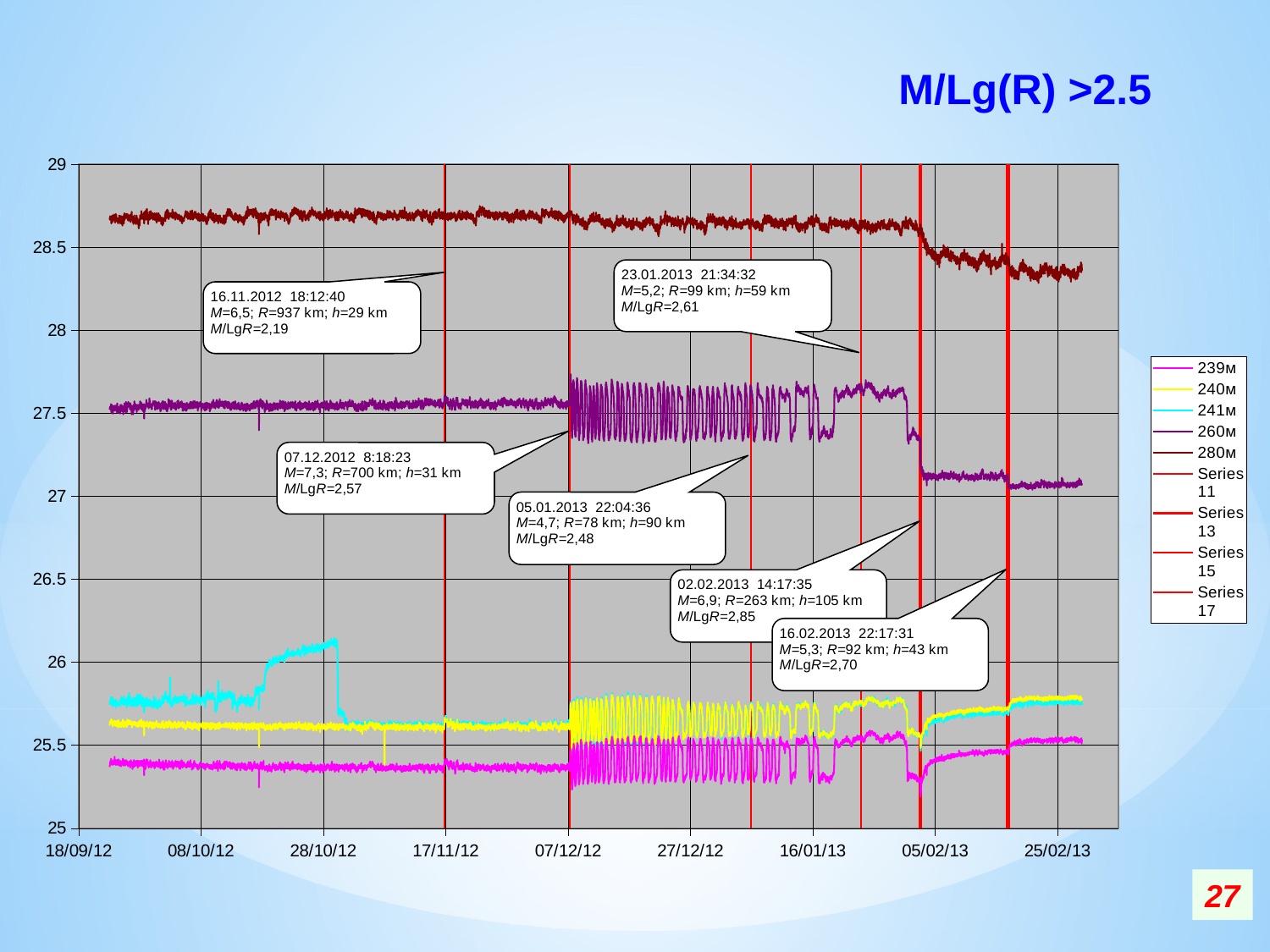
What is the title of the chart? M/Lg(R) >2.5 Which series has the highest values on the chart? 280м Which series has larger values, 280м or 260м? 280м Is the value of the 260м series at the end of the chart greater or less than 27.5? less What magnitude M is given in the annotation for the event on 07.12.2012? 7,3 What is the M/LgR value given in the annotation for the event on 02.02.2013? 2,85 Which series has the lowest values on the chart? 239м Does the 280м series rise or fall over the period shown? fall Is the value of the 280м series at the start of the chart greater or less than 28.5? greater How many entries does the chart legend list? 9 What kind of chart is shown on the slide? line chart Is the value of the 239м series at the start of the chart greater or less than 25.5? less